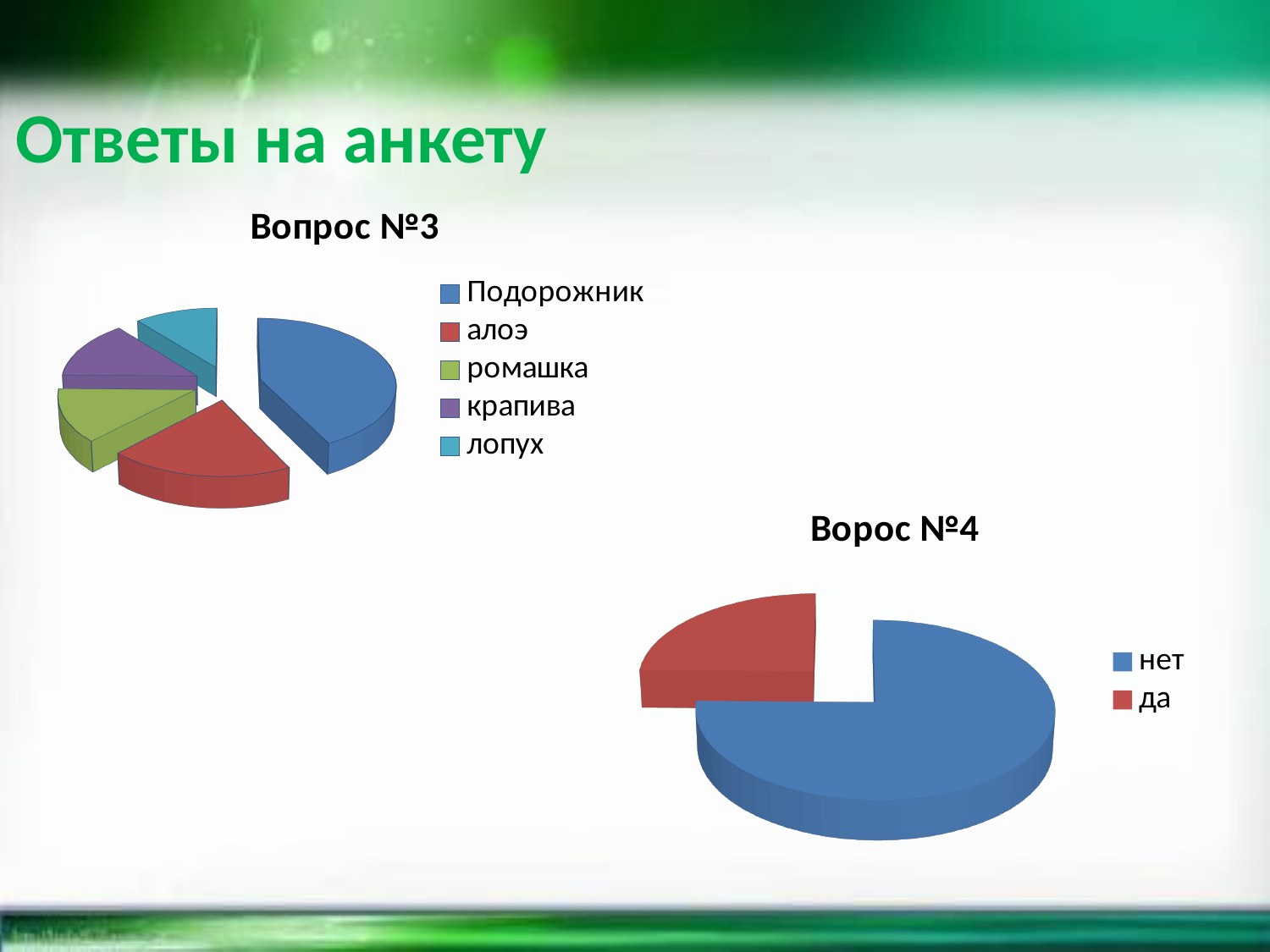
In the "Вопрос №3" chart, which slice is larger, Подорожник or алоэ? Подорожник In the "Вопрос №3" chart, which category has the largest slice? Подорожник What is the title of the chart at the bottom right of the slide? Ворос №4 In the "Вопрос №3" chart, which slice is larger, алоэ or ромашка? алоэ In the "Ворос №4" chart, which answer has the largest slice? нет What kind of chart is the "Вопрос №3" chart? pie chart What kind of chart is the "Ворос №4" chart? pie chart In the "Ворос №4" chart, how many slices are there? 2 In the "Вопрос №3" chart, how many categories does the legend list? 5 In the "Ворос №4" chart, which answer has the smallest slice? да In the "Ворос №4" chart, which slice is larger, нет or да? нет In the "Вопрос №3" chart, which colour represents крапива in the legend? purple